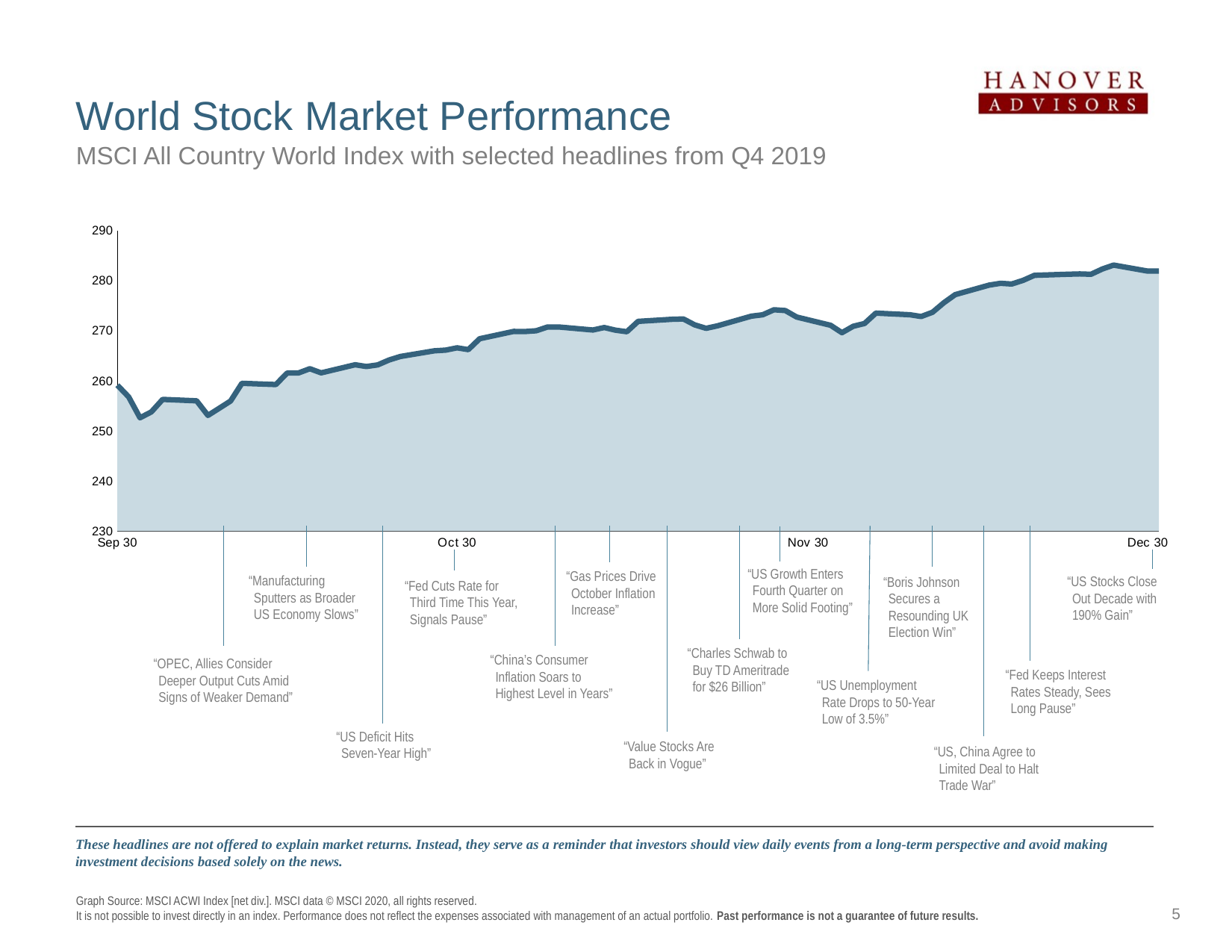
Is the index value at Oct 30 greater or less than 270? less Is the lowest point of the index in early October greater or less than 260? less What is the subtitle of the chart? MSCI All Country World Index with selected headlines from Q4 2019 What kind of chart is shown on the slide? Area chart Which of the labeled dates on the x axis has the highest index value? Dec 30 Is the index value at Oct 30 greater or less than 260? greater Which of the labeled dates on the x axis has the lowest index value? Sep 30 Is the index value higher at Oct 30 or at Nov 30? Nov 30 How many dates are labeled on the x axis? 4 Does the index value generally rise or fall from Sep 30 to Dec 30? Rise